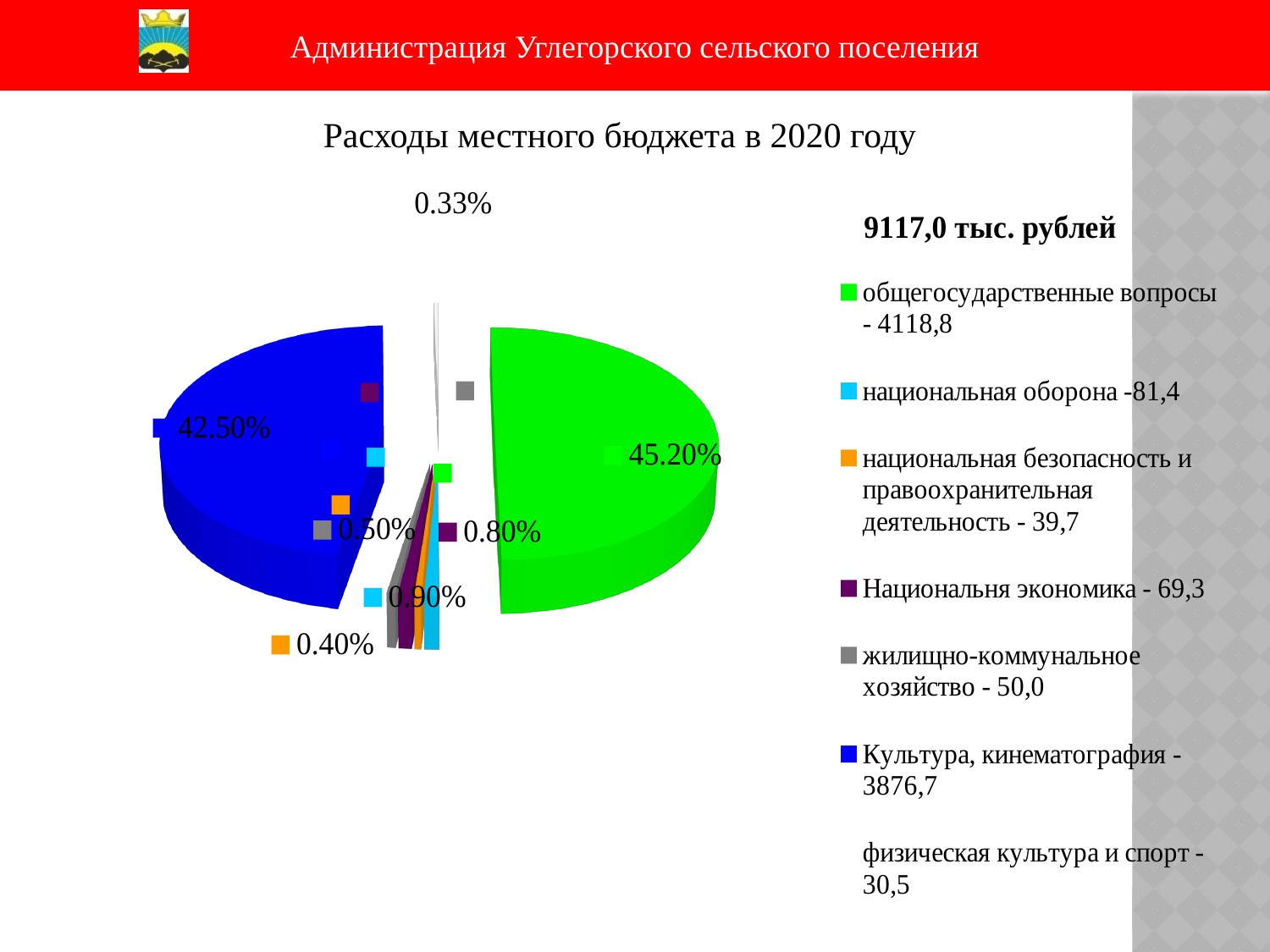
What share of the pie is labelled for физическая культура и спорт? 0.33% What share of the pie is labelled for Культура, кинематография? 42.50% What kind of chart is shown on the slide? pie chart Which category has the smallest slice of the pie? физическая культура и спорт What is the title of the chart? 9117,0 тыс. рублей How many categories does the legend list? 7 Which slice is larger: общегосударственные вопросы or Культура, кинематография? общегосударственные вопросы Which category has the largest slice of the pie? общегосударственные вопросы What share of the pie is labelled for общегосударственные вопросы? 45.20% What amount is listed in the legend for национальная оборона? 81,4 What total amount of expenditure is printed above the legend? 9117,0 тыс. рублей What is the difference in percentage points between the общегосударственные вопросы slice (45.20%) and the Культура, кинематография slice (42.50%)? 2.70%